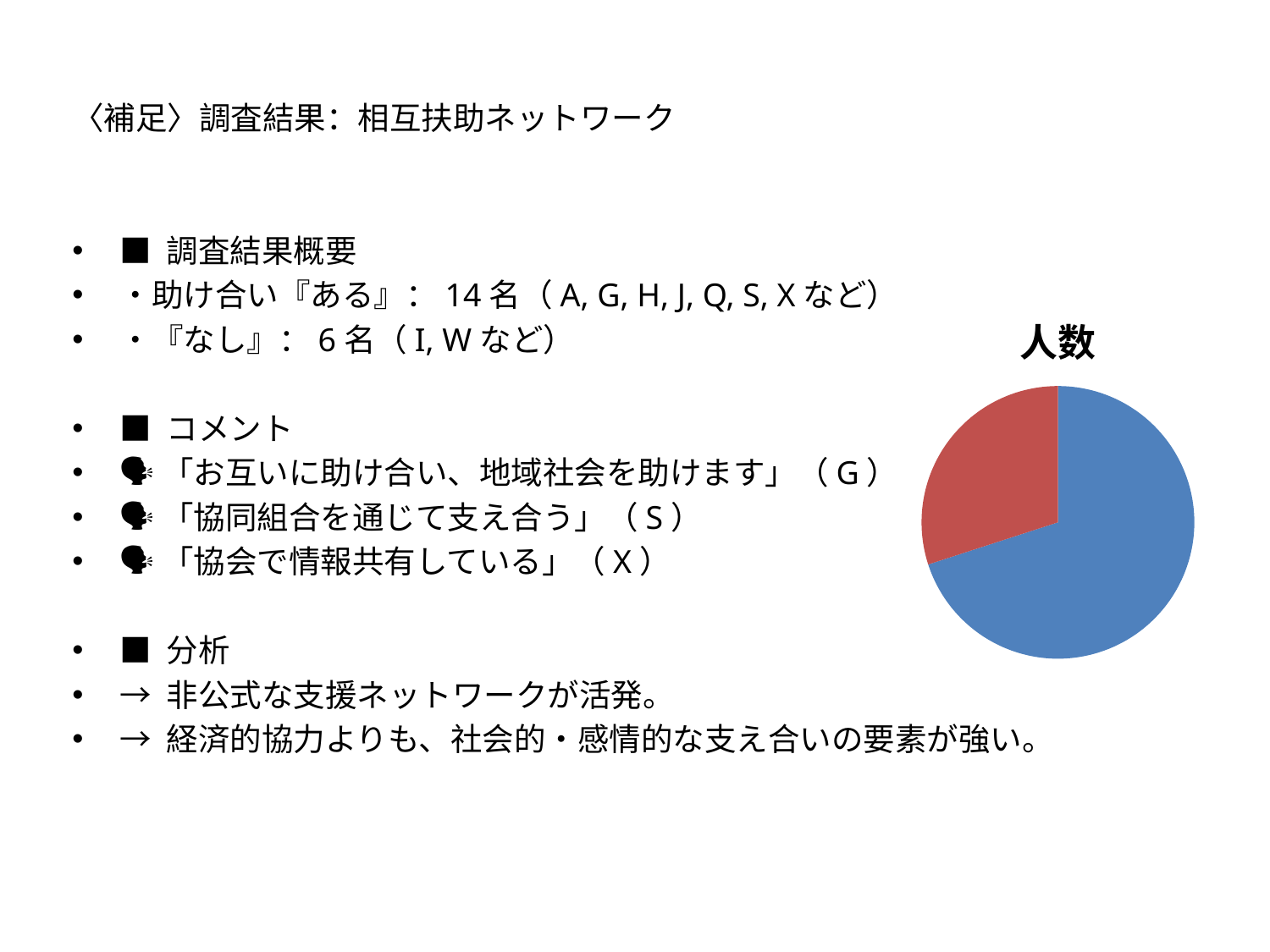
Which colour is the smallest slice of the pie chart? red What kind of chart is shown on the slide? pie chart How many slices does the pie chart have? 2 Does the pie chart display a legend? no Which slice of the pie chart is larger, the blue one or the red one? the blue one Which colour is the largest slice of the pie chart? blue What is the title of the pie chart? 人数